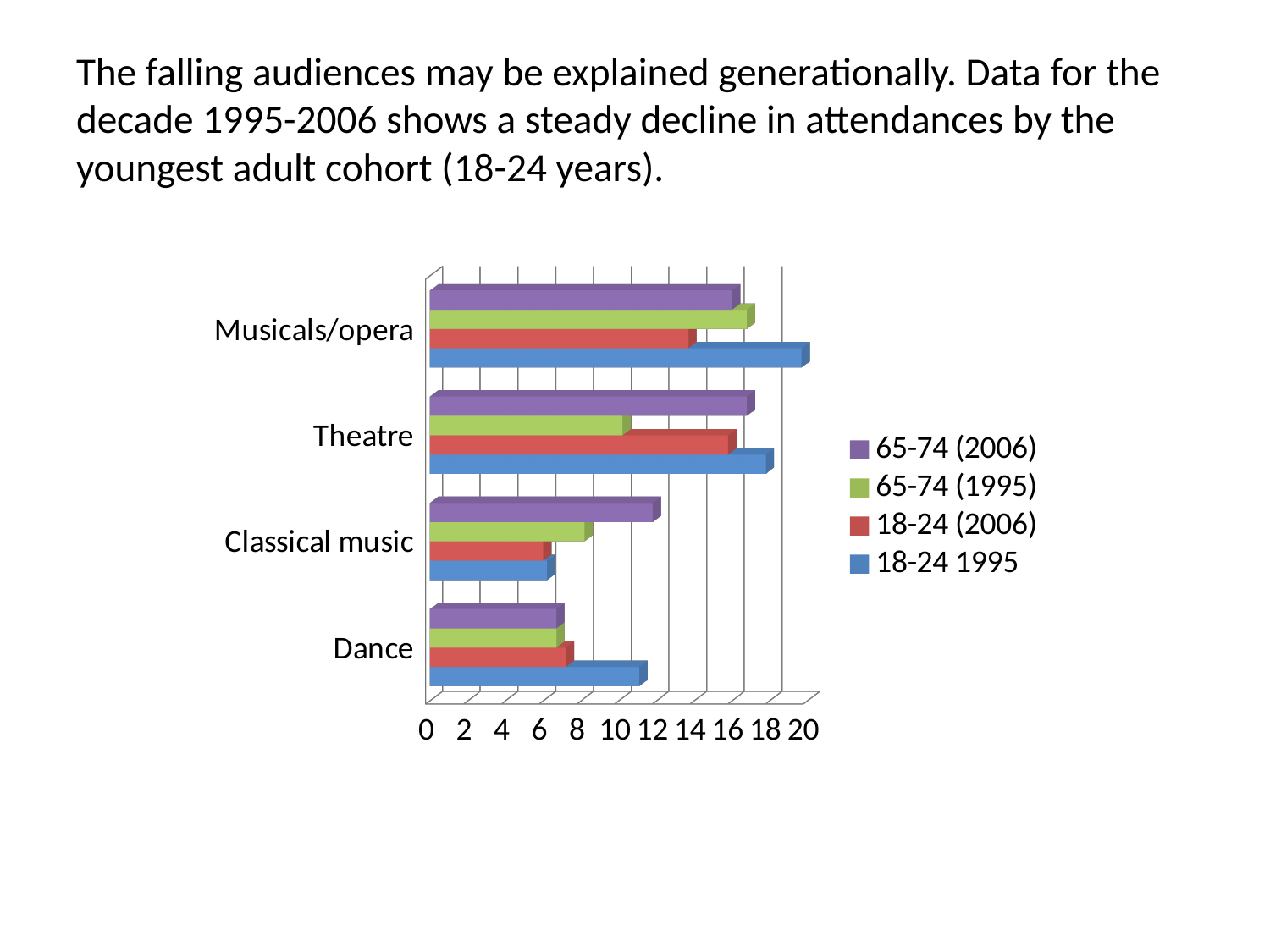
Is the value for 18-24 1995 in Dance greater or less than 10? greater Which category has the highest value for 18-24 1995? Musicals/opera For Dance, which is larger: 18-24 1995 or 18-24 (2006)? 18-24 1995 Which category has the lowest value for 65-74 (2006)? Dance How many categories are shown on the chart? 4 What kind of chart is shown on the slide? Bar chart Is the value for 18-24 (2006) in Classical music greater or less than 8? less Is the value for 65-74 (1995) in Theatre greater or less than 12? less How many series does the legend list? 4 Which series is shown in blue in the legend? 18-24 1995 For Theatre, which is larger: 65-74 (2006) or 65-74 (1995)? 65-74 (2006)